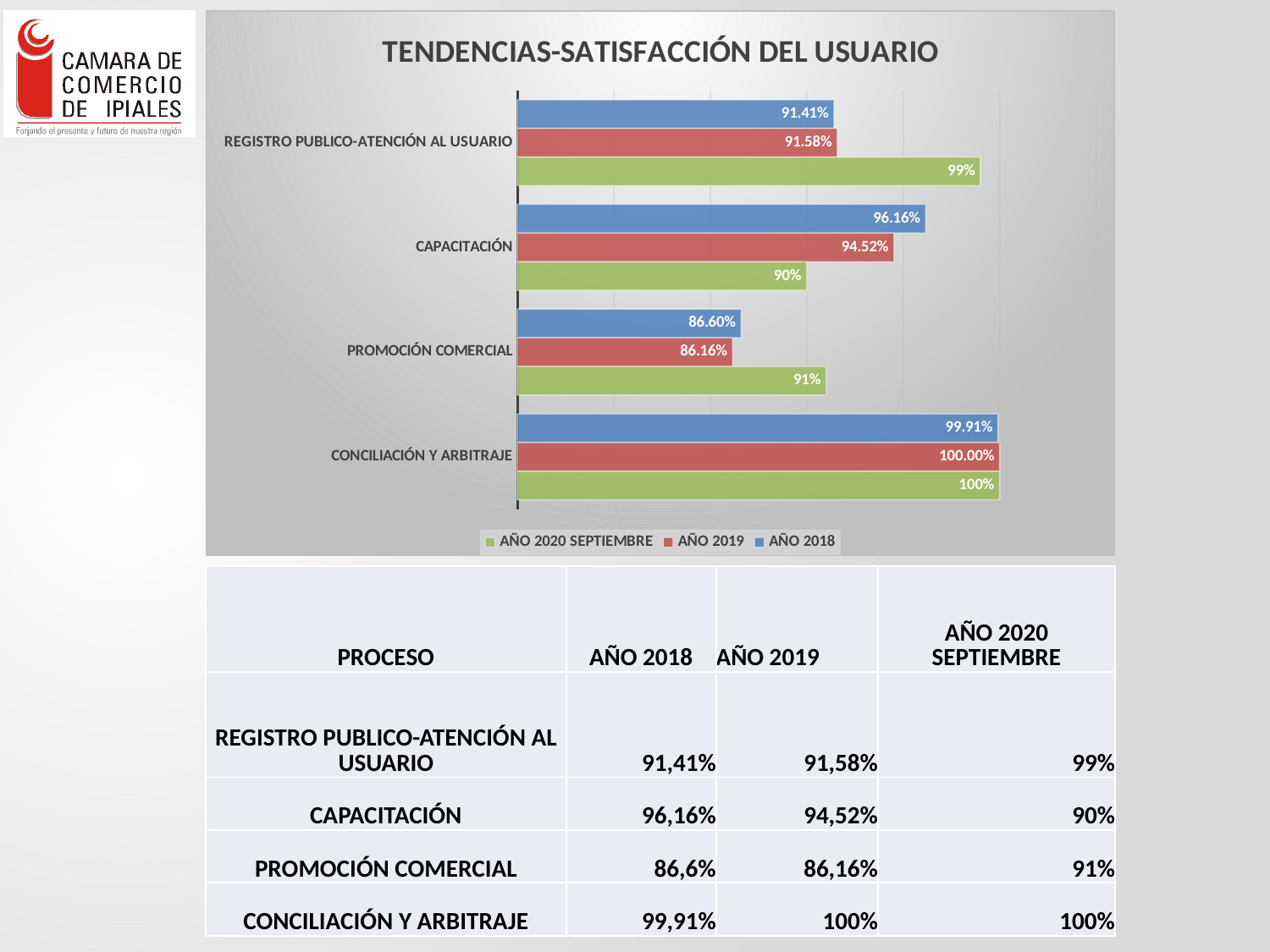
What is the AÑO 2018 value for CONCILIACIÓN Y ARBITRAJE in the chart? 99.91% What is the AÑO 2020 SEPTIEMBRE value for REGISTRO PUBLICO-ATENCIÓN AL USUARIO in the chart? 99% How many series does the chart legend list? 3 What type of chart is shown on the slide? Bar chart How many categories are shown in the chart? 4 For PROMOCIÓN COMERCIAL, which is larger: the AÑO 2020 SEPTIEMBRE value or the AÑO 2019 value? AÑO 2020 SEPTIEMBRE Which category has the lowest AÑO 2018 value in the chart? PROMOCIÓN COMERCIAL What is the title of the chart? TENDENCIAS-SATISFACCIÓN DEL USUARIO What is the difference between the AÑO 2018 and AÑO 2020 SEPTIEMBRE values for CAPACITACIÓN? 6.16% What is the AÑO 2018 value for CAPACITACIÓN in the chart? 96.16% Which category has the highest AÑO 2020 SEPTIEMBRE value in the chart? CONCILIACIÓN Y ARBITRAJE What is the AÑO 2019 value for PROMOCIÓN COMERCIAL in the chart? 86.16%